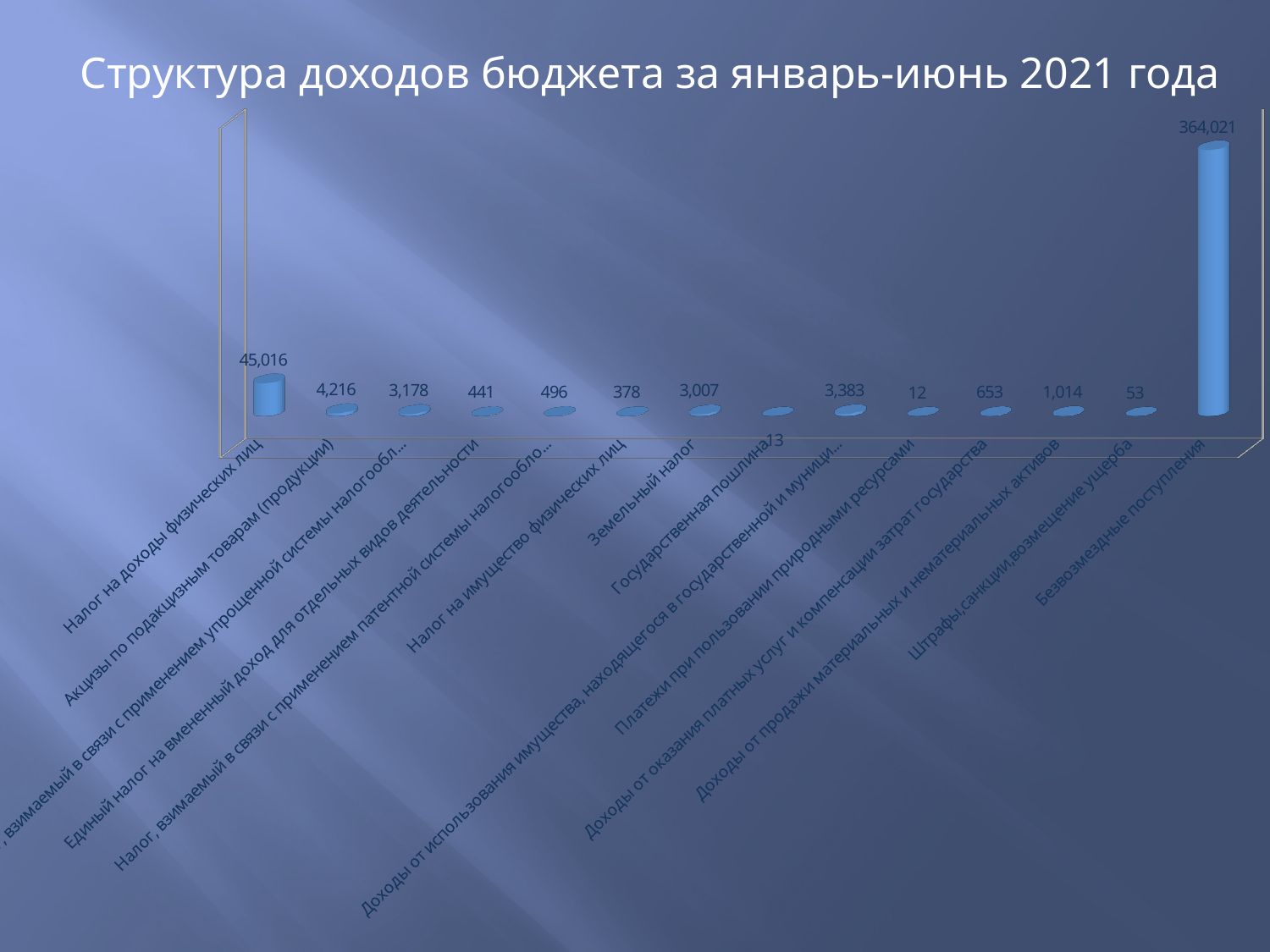
What is the value for Земельный налог? 3,007 Which category has the highest value? Безвозмездные поступления How many categories are shown in the chart? 14 What is the value for Налог на доходы физических лиц? 45,016 What is the difference between the values for Безвозмездные поступления and Налог на доходы физических лиц? 319,005 What is the value for Доходы от продажи материальных и нематериальных активов? 1,014 What is the difference between the values for Доходы от продажи материальных и нематериальных активов and Доходы от оказания платных услуг и компенсации затрат государства? 361 What kind of chart is shown on the slide? Bar chart What is the value for Безвозмездные поступления? 364,021 Which is larger: the value for Земельный налог or the value for Акцизы по подакцизным товарам (продукции)? Акцизы по подакцизным товарам (продукции) What is the value for Штрафы,санкции,возмещение ущерба? 53 Which category has the lowest value? Государственная пошлина